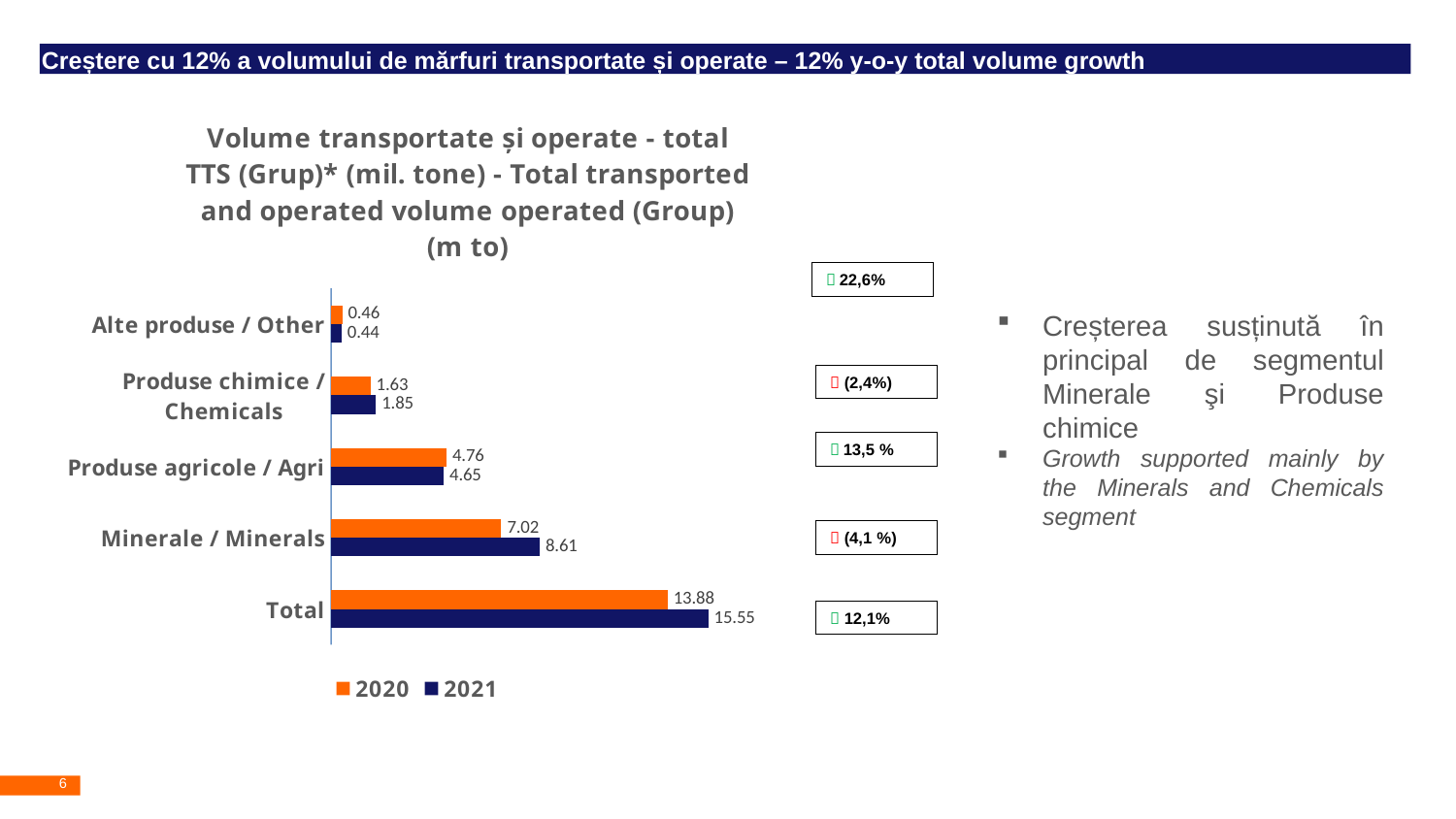
What was the Total value for 2021? 15.55 What was the 2020 value for Alte produse / Other? 0.46 What type of chart is shown on the slide? Bar chart How many categories are shown on the chart? 5 Excluding Total, which category had the highest 2021 value? Minerale / Minerals What was the 2021 value for Minerale / Minerals? 8.61 Which category had the lowest 2020 value? Alte produse / Other How many series does the legend list? 2 What was the 2020 value for Produse chimice / Chemicals? 1.63 What is the difference between the 2021 and 2020 values for Minerale / Minerals? 1.59 What is the difference between the Total values for 2021 and 2020? 1.67 For Produse agricole / Agri, which year had the larger value, 2020 or 2021? 2020